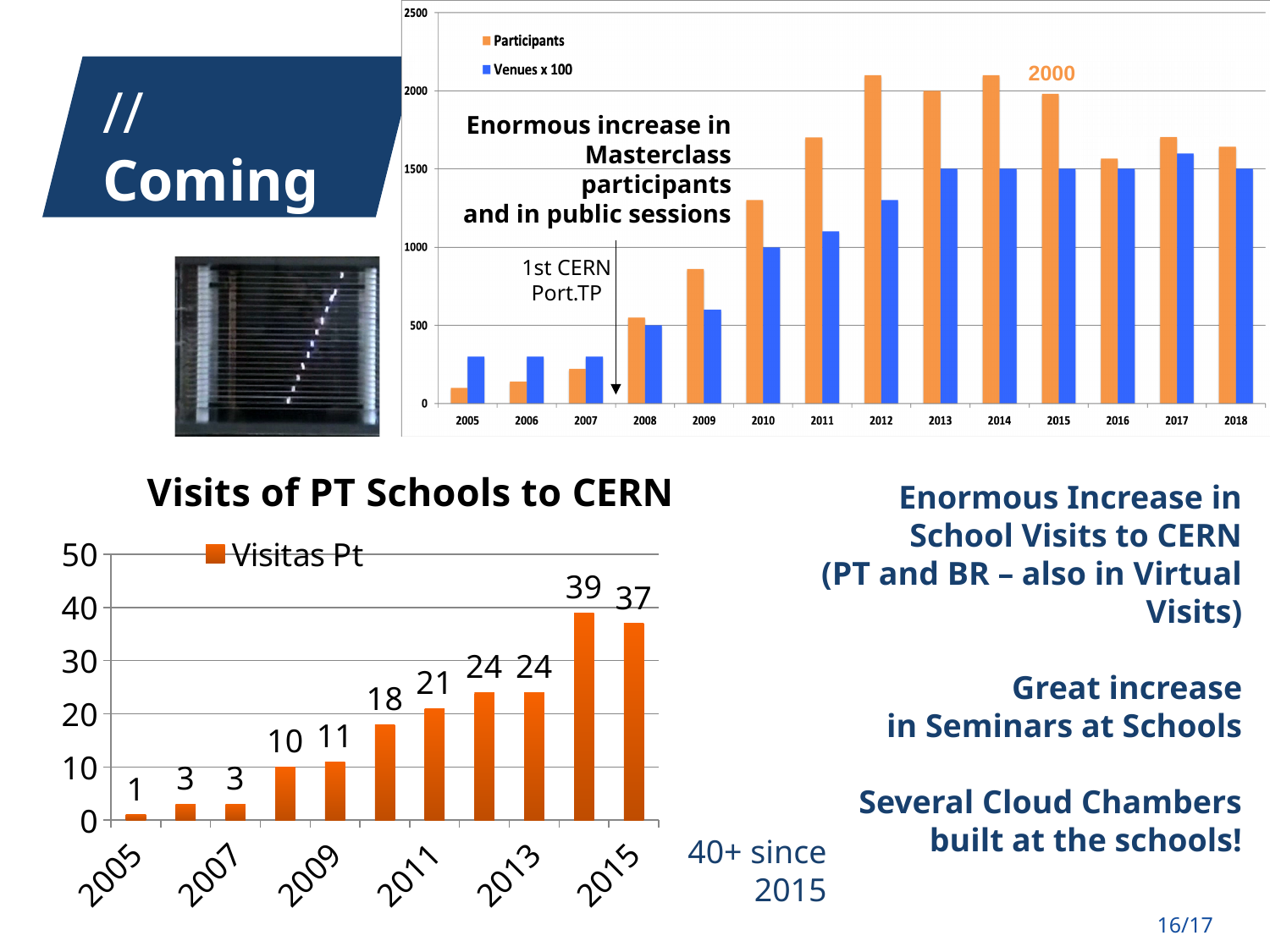
In the 'Visits of PT Schools to CERN' chart, which year has the lowest value? 2005 In the 'Visits of PT Schools to CERN' chart, which year has the highest value? 2014 In the top chart (Masterclass participants), is the value for Participants in 2012 greater or less than 2000? greater In the 'Visits of PT Schools to CERN' chart, what is the name of the series shown in the legend? Visitas Pt In the 'Visits of PT Schools to CERN' chart, how many bars are plotted? 11 In the 'Visits of PT Schools to CERN' chart, what is the value for 2014? 39 In the 'Visits of PT Schools to CERN' chart, what is the difference between the values for 2014 and 2015? 2 In the top chart (Masterclass participants), is the value for Venues x 100 in 2005 greater or less than 500? less In the 'Visits of PT Schools to CERN' chart, which is larger, the value for 2011 or the value for 2009? 2011 In the top chart (Masterclass participants), how many series does the legend list? 2 What kind of chart is the 'Visits of PT Schools to CERN' chart? bar chart In the 'Visits of PT Schools to CERN' chart, what is the value for 2010? 18